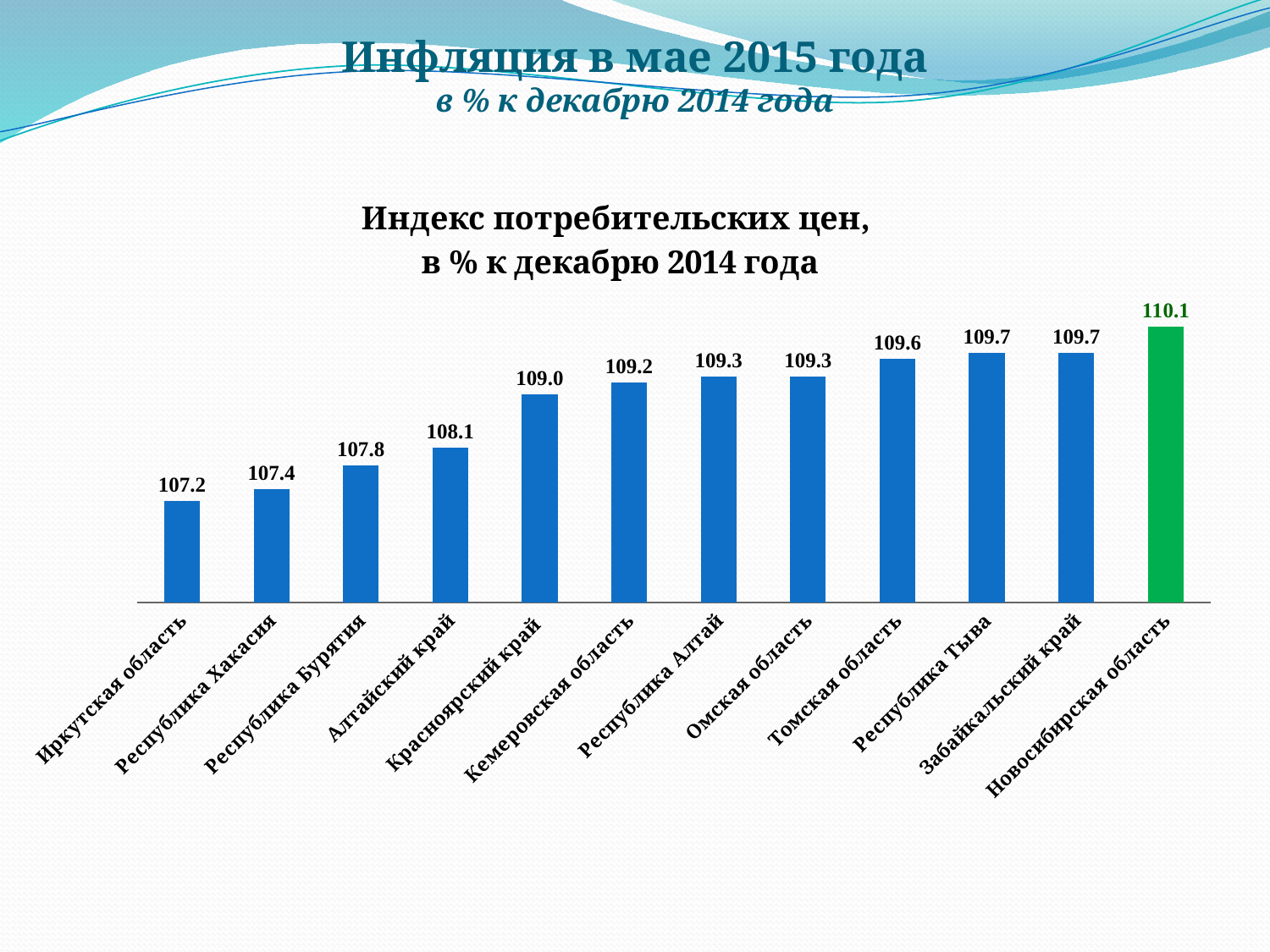
What is the difference between the values for Новосибирская область and Иркутская область? 2.9 Which region has the highest value? Новосибирская область Which is larger, the value for Республика Хакасия or the value for Кемеровская область? Кемеровская область What is the difference between the values for Томская область and Республика Бурятия? 1.8 What is the value for Красноярский край? 109.0 What is the value for Алтайский край? 108.1 Which region has the lowest value? Иркутская область What is the value for Новосибирская область? 110.1 Which bar is coloured green rather than blue? Новосибирская область What kind of chart is shown on the slide? bar chart What is the value for Иркутская область? 107.2 How many regions are shown in the chart? 12